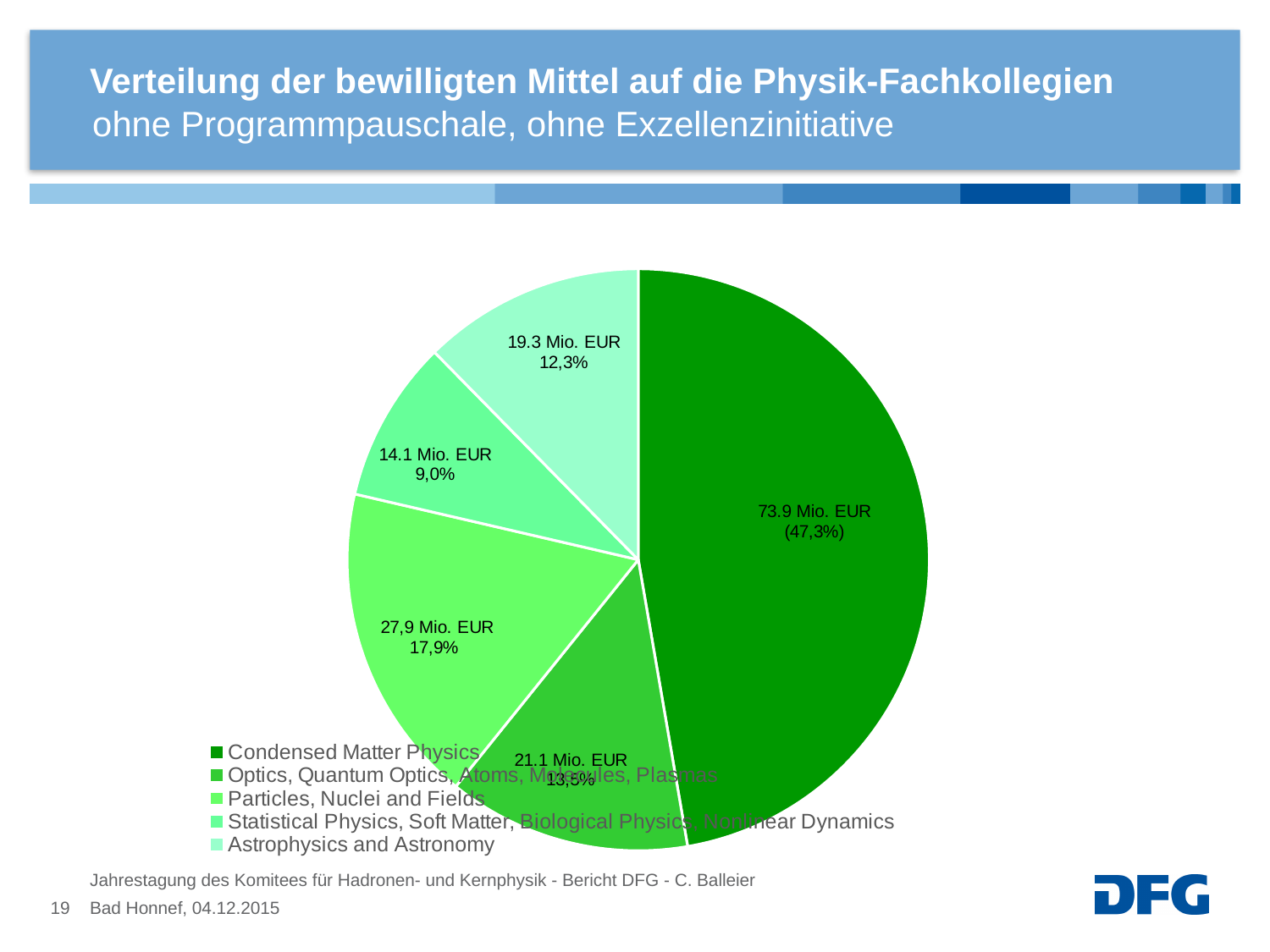
What amount is shown for Statistical Physics, Soft Matter, Biological Physics, Nonlinear Dynamics? 14.1 Mio. EUR What is the difference in percentage points between the Astrophysics and Astronomy share (12,3%) and the Statistical Physics share (9,0%)? 3,3 percentage points Which category has the largest slice of the pie? Condensed Matter Physics Which has the larger share: Particles, Nuclei and Fields or Astrophysics and Astronomy? Particles, Nuclei and Fields What amount is shown for Condensed Matter Physics? 73.9 Mio. EUR What share of the pie does Condensed Matter Physics have? 47,3% What amount is shown for Astrophysics and Astronomy? 19.3 Mio. EUR Which category has the smallest slice of the pie? Statistical Physics, Soft Matter, Biological Physics, Nonlinear Dynamics What share of the pie does Particles, Nuclei and Fields have? 17,9% How many entries does the legend list? 5 How many slices does the pie chart have? 5 What kind of chart is shown on the slide? pie chart